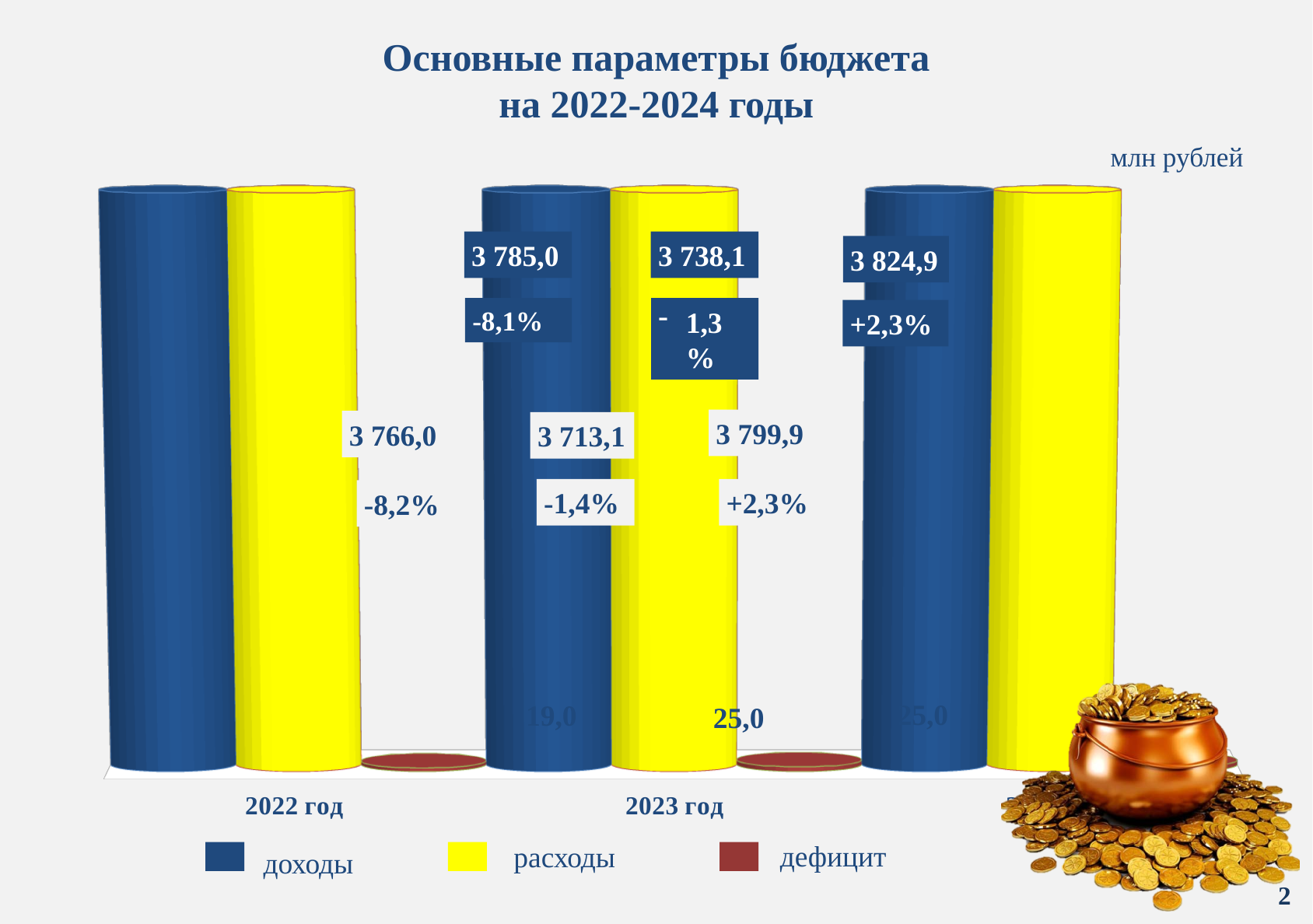
What kind of chart is shown on the slide? bar chart What is the value of расходы for 2023 год? 3 738,1 What is the title of the chart? Основные параметры бюджета на 2022-2024 годы What is the value of доходы for 2023 год? 3 713,1 How many series does the legend list? 3 What is the value of доходы for 2022 год? 3 766,0 What are the three series named in the legend? доходы, расходы, дефицит What is the value of расходы for 2022 год? 3 785,0